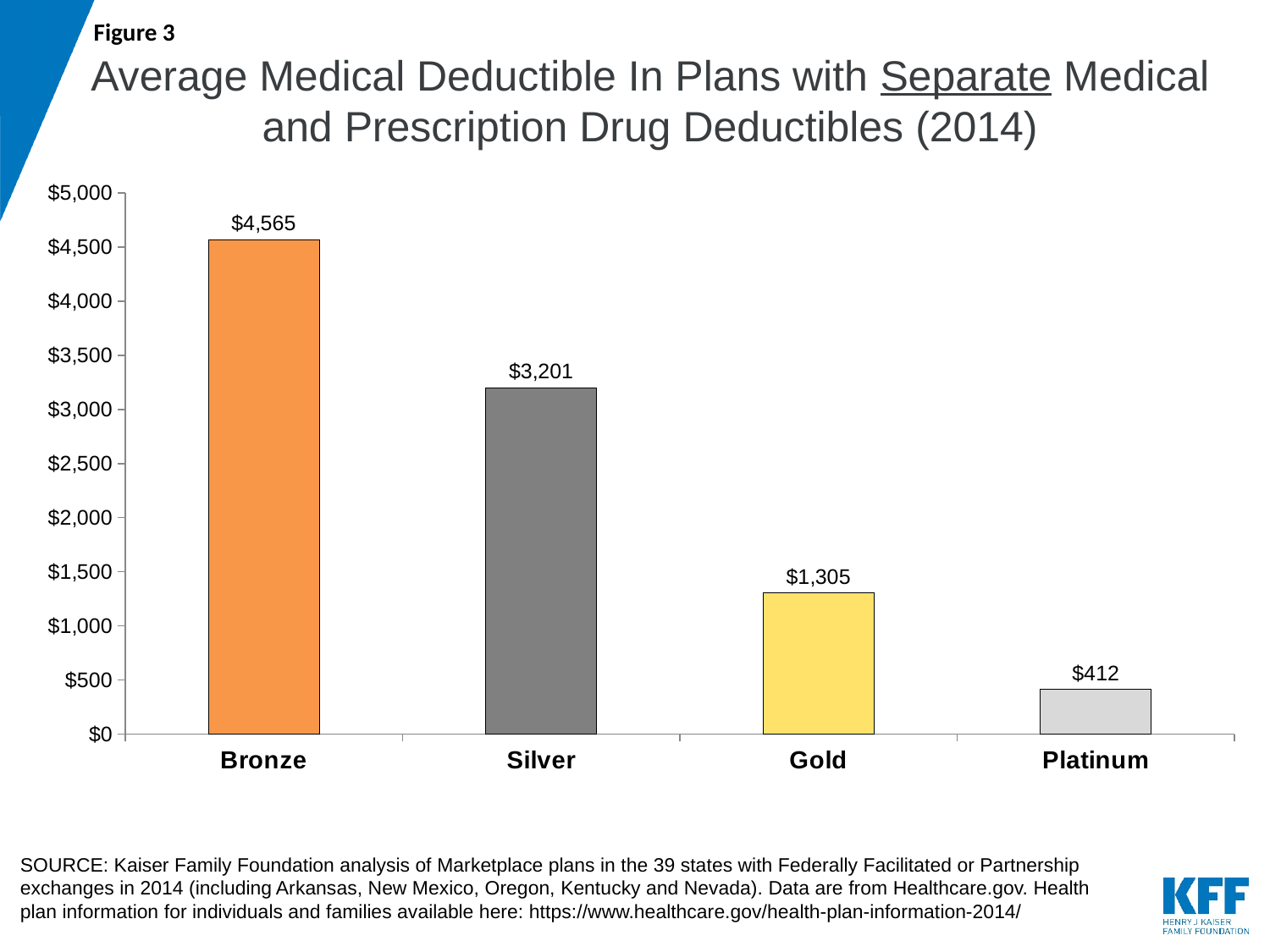
What kind of chart is shown on the slide? Bar chart What is the average medical deductible for Bronze plans? $4,565 What is the average medical deductible for Platinum plans? $412 What is the average medical deductible for Gold plans? $1,305 What is the difference between the Bronze and Silver average medical deductibles? $1,364 How many plan types are shown on the chart? 4 What is the average medical deductible for Silver plans? $3,201 Which has a larger average medical deductible, Silver or Gold? Silver Which plan type has the lowest average medical deductible? Platinum Is the value for Gold greater or less than $1,500? less Which plan type has the highest average medical deductible? Bronze What is the difference between the Gold and Platinum average medical deductibles? $893